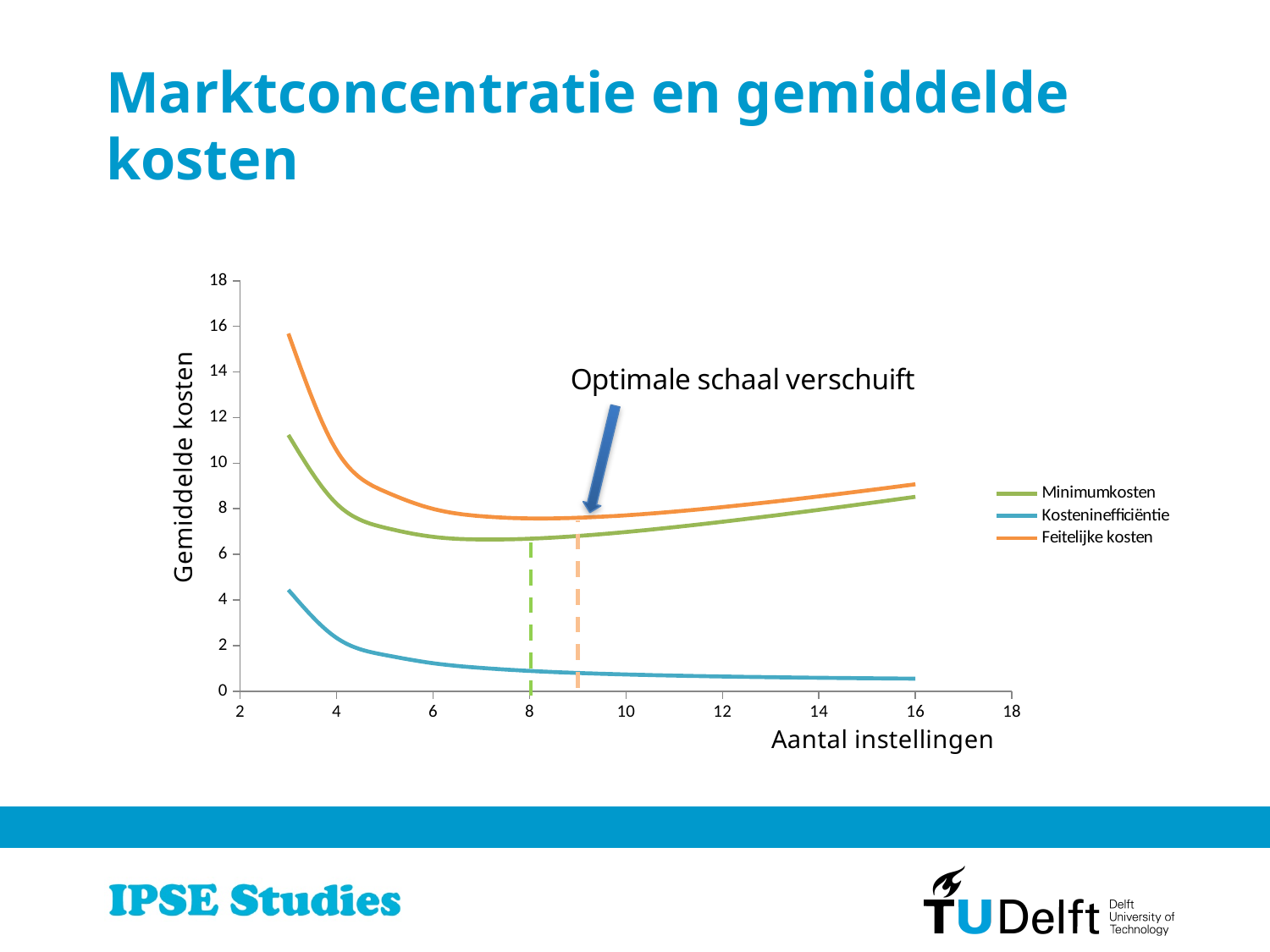
What kind of chart is shown on the slide? line chart How many series does the legend list? 3 What is the title of the slide containing the chart? Marktconcentratie en gemiddelde kosten Is the value of Feitelijke kosten at 3 instellingen greater or less than 14? greater What is the label of the x axis? Aantal instellingen Which series has the lowest values across the whole x axis? Kosteninefficiëntie Does the Kosteninefficiëntie line rise or fall as the number of instellingen increases? fall Is the value of Feitelijke kosten at 16 instellingen greater or less than 8? greater At 3 instellingen, which is higher: Feitelijke kosten or Minimumkosten? Feitelijke kosten Is the value of Kosteninefficiëntie at 16 instellingen greater or less than 2? less